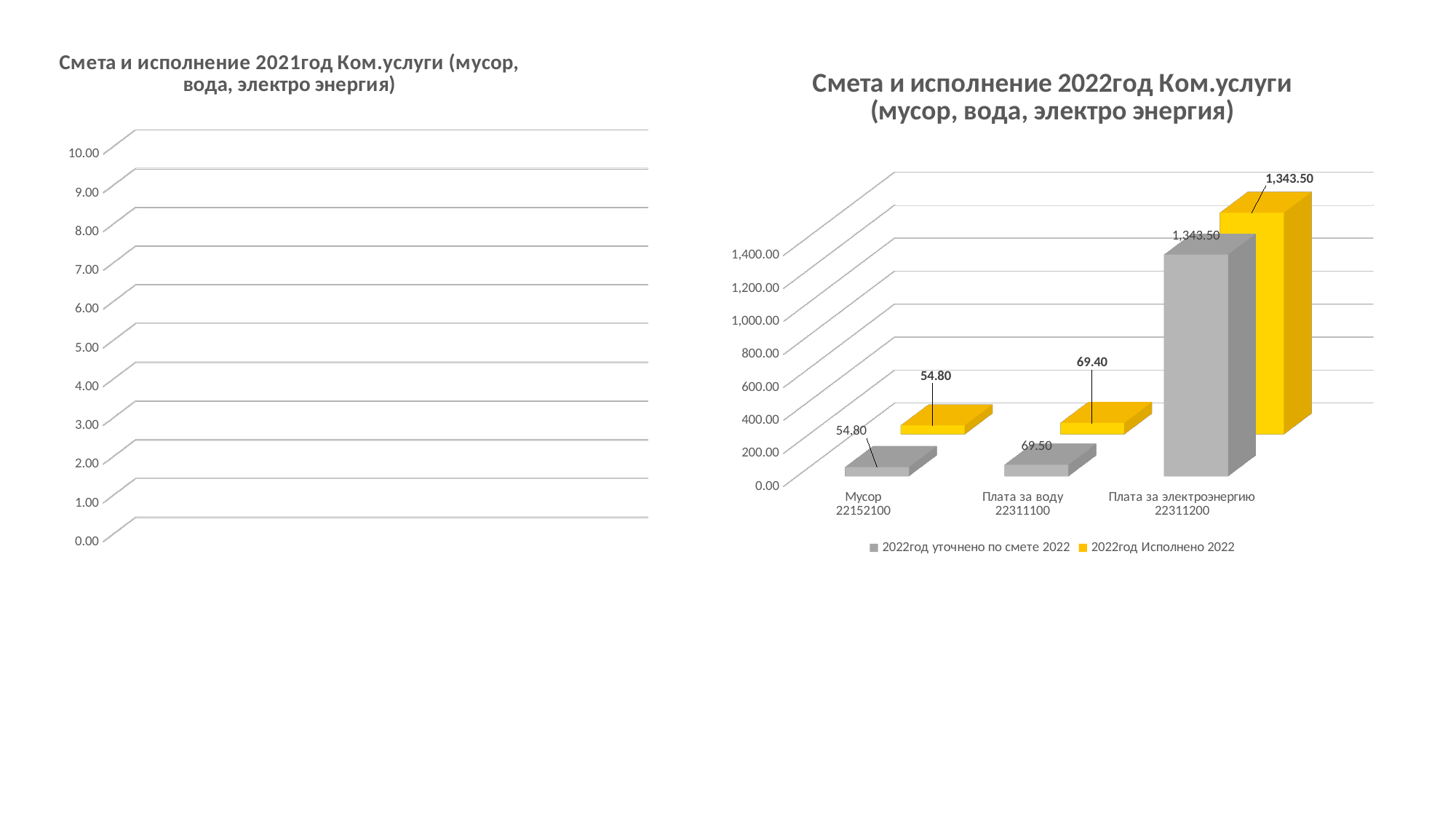
How many series does the legend of the chart on the right of the slide list? 2 In the chart on the right of the slide, what is the difference between '2022год уточнено по смете 2022' and '2022год Исполнено 2022' for 'Плата за воду 22311100'? 0.10 In the chart on the right of the slide, what is the difference between the '2022год Исполнено 2022' values for 'Плата за электроэнергию 22311200' and 'Мусор 22152100'? 1,288.70 In the chart titled 'Смета и исполнение 2022год Ком.услуги (мусор, вода, электро энергия)', what is the value of '2022год Исполнено 2022' for 'Мусор 22152100'? 54.80 In the chart titled 'Смета и исполнение 2022год Ком.услуги (мусор, вода, электро энергия)', what is the value of '2022год уточнено по смете 2022' for 'Плата за электроэнергию 22311200'? 1,343.50 In the chart on the right of the slide, which category has the highest value for '2022год Исполнено 2022'? Плата за электроэнергию 22311200 In the chart on the right of the slide, which category has the lowest value for '2022год уточнено по смете 2022'? Мусор 22152100 How many categories are shown on the x axis of the chart on the right of the slide? 3 What kind of chart is the chart on the right of the slide? Bar chart In the chart titled 'Смета и исполнение 2022год Ком.услуги (мусор, вода, электро энергия)', what is the value of '2022год Исполнено 2022' for 'Плата за воду 22311100'? 69.40 In the chart titled 'Смета и исполнение 2022год Ком.услуги (мусор, вода, электро энергия)', what is the value of '2022год уточнено по смете 2022' for 'Плата за воду 22311100'? 69.50 In the chart on the right of the slide, which is larger: the '2022год уточнено по смете 2022' value for 'Плата за воду 22311100' or for 'Мусор 22152100'? Плата за воду 22311100